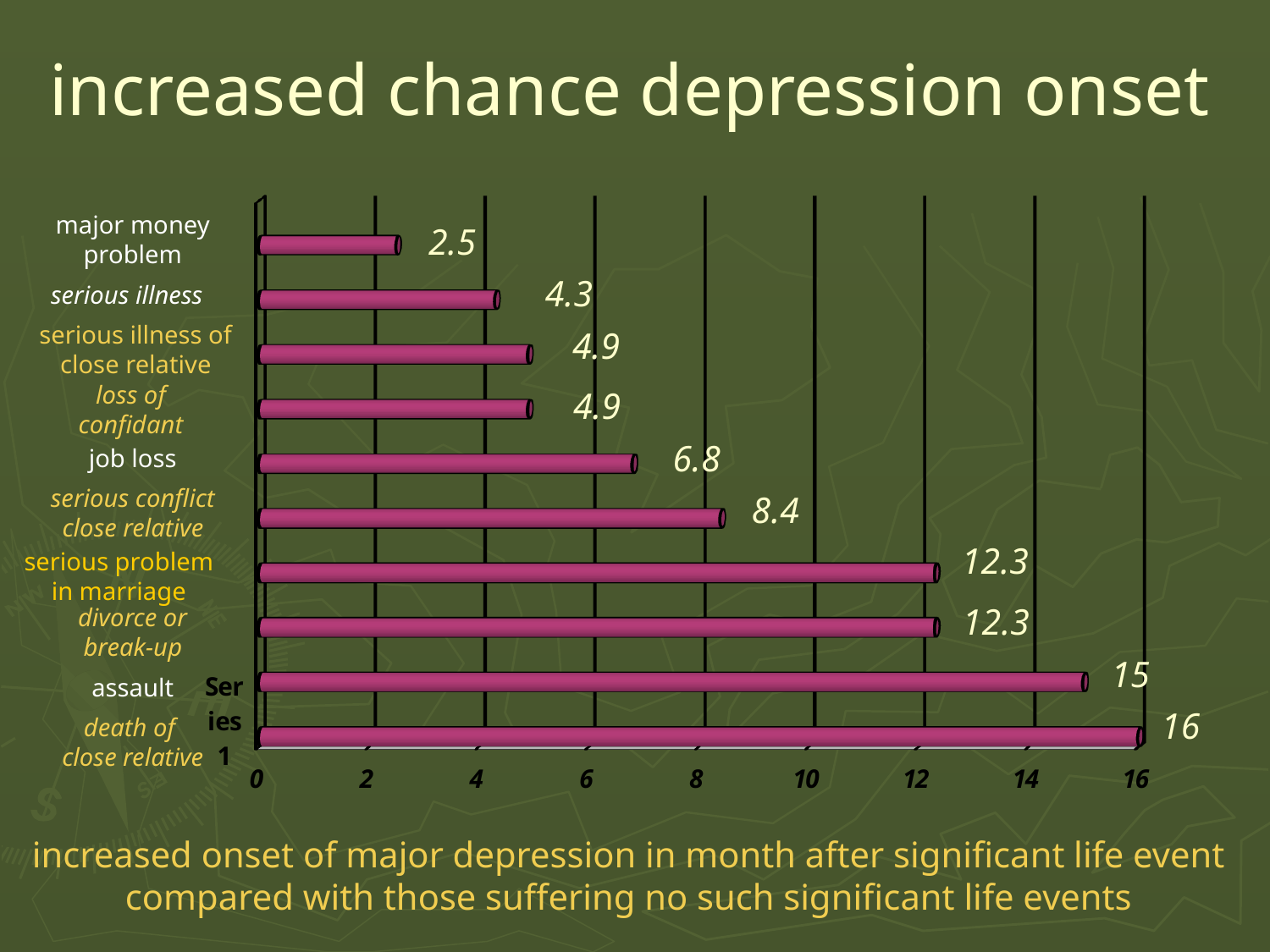
What is the value for job loss? 6.8 What is the value for assault? 15 What is the value for serious conflict close relative? 8.4 Which category has the highest value? death of close relative Which is larger, the value for serious illness or the value for job loss? job loss What is the difference between the values for death of close relative and assault? 1 What is the difference between the values for serious problem in marriage and job loss? 5.5 How many categories are shown in the chart? 10 What kind of chart is shown on the slide? bar chart What is the title of the chart? increased chance depression onset What is the value for major money problem? 2.5 Which category has the lowest value? major money problem